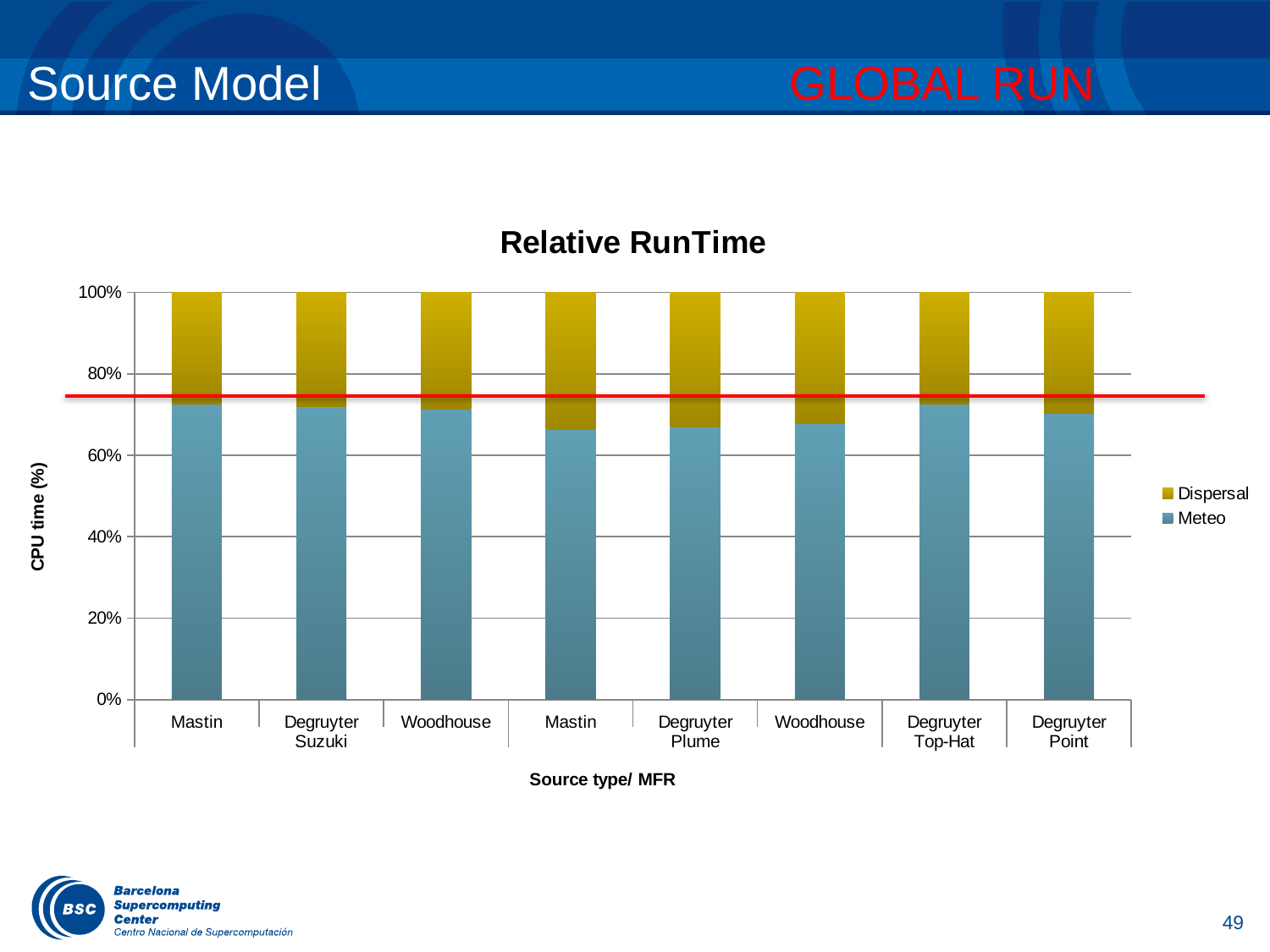
What is the label of the vertical axis? CPU time (%) How many series does the legend of the Relative RunTime chart list? 2 Is the Meteo value for Woodhouse under Plume greater or less than 80%? less Is the Meteo value for Degruyter Top-Hat greater or less than 60%? greater Is the Meteo value for Mastin under Plume greater or less than 60%? greater Which is larger, the Meteo value for Mastin under Suzuki or the Meteo value for Mastin under Plume? Mastin under Suzuki Which series is larger for Degruyter Point, Meteo or Dispersal? Meteo What is the total height of the stacked bar for Mastin under Suzuki? 100% What kind of chart is shown on the slide? Stacked bar chart What is the title of the chart? Relative RunTime How many bars are plotted in the Relative RunTime chart? 8